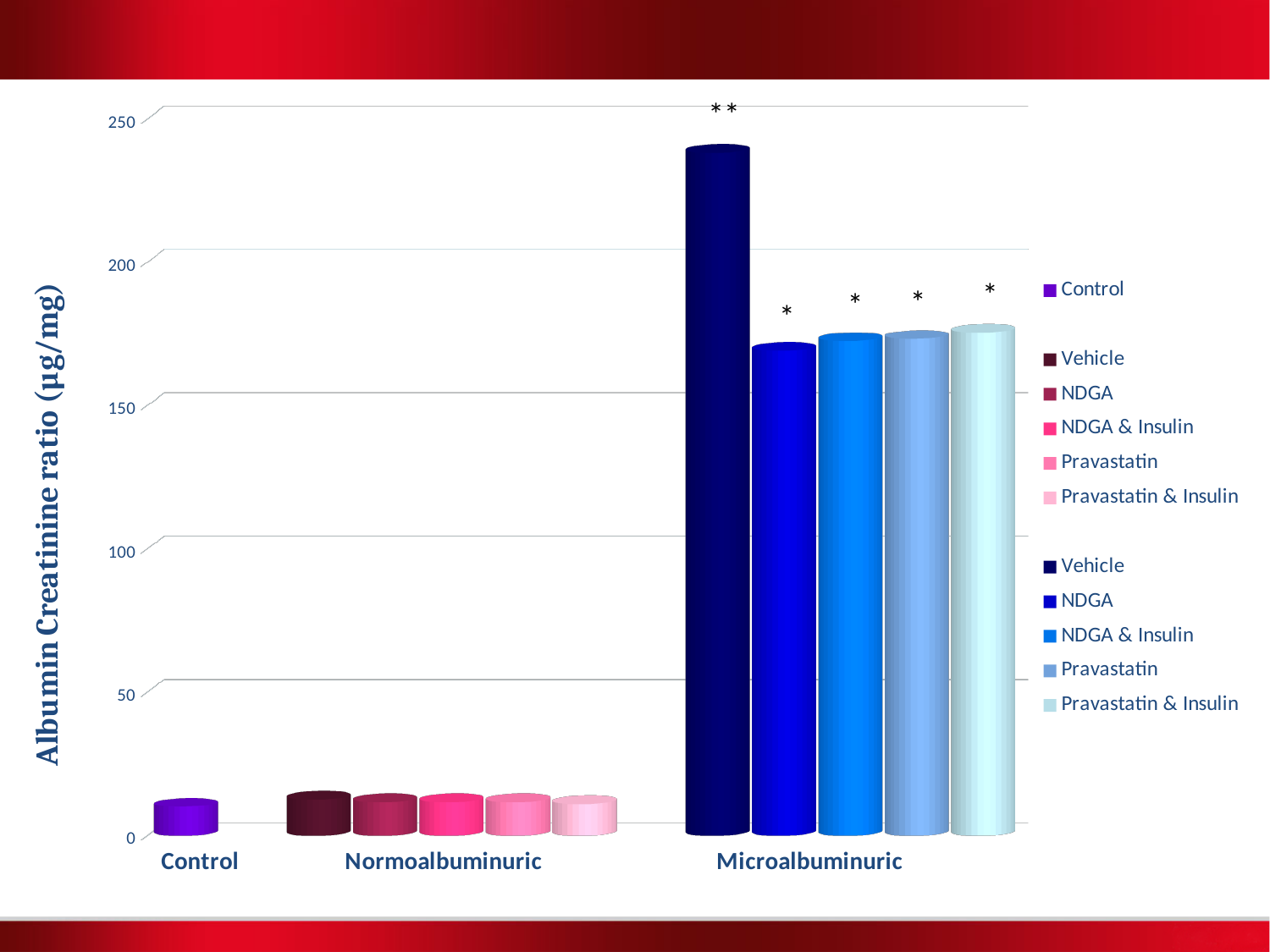
What is the label of the y axis? Albumin Creatinine ratio (µg/mg) Which bar is the tallest on the chart? Vehicle in the Microalbuminuric group How many entries does the legend list? 11 Is the value for Vehicle in the Normoalbuminuric group greater or less than 50? less Is the value for NDGA in the Microalbuminuric group greater or less than 150? greater Which is larger: Vehicle or NDGA in the Microalbuminuric group? Vehicle Do the bar heights generally rise or fall moving from Control to Microalbuminuric along the x axis? rise Is the value for Control greater or less than 50? less How many categories are shown along the x axis? 3 What kind of chart is shown on the slide? bar chart